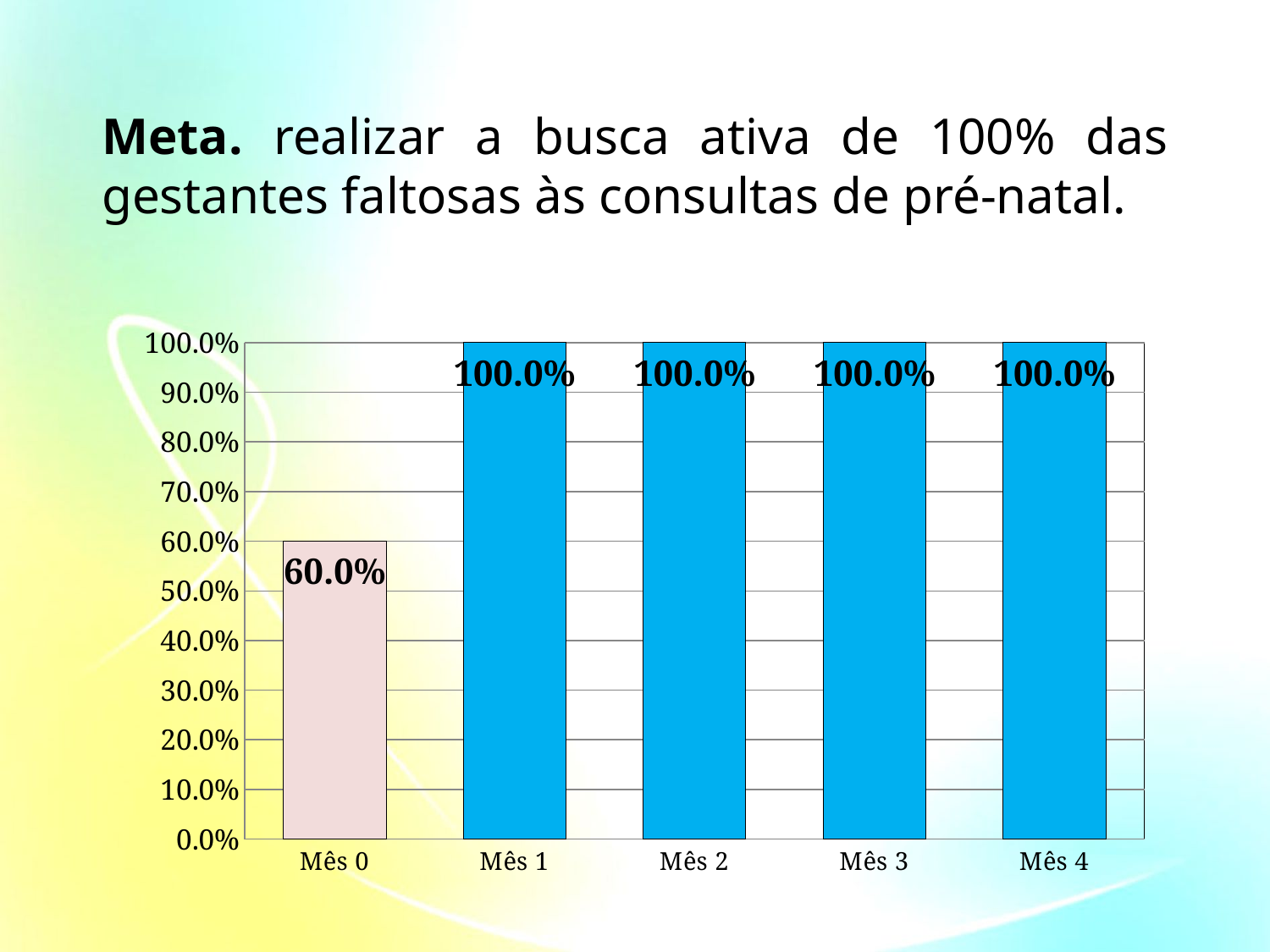
Which is larger, the value for Mês 0 or the value for Mês 3? Mês 3 What is the difference between the values for Mês 1 and Mês 0? 40.0% What is the highest value shown on the y axis? 100.0% What is the value for Mês 2? 100.0% Which category has the lowest value? Mês 0 Do the values rise or fall from Mês 0 to Mês 1? rise Which bar is a different colour from the others? Mês 0 How many categories are shown on the x axis? 5 What is the value for Mês 4? 100.0% What kind of chart is shown on the slide? bar chart What is the value for Mês 0? 60.0% Is the value for Mês 0 greater or less than 50.0%? greater